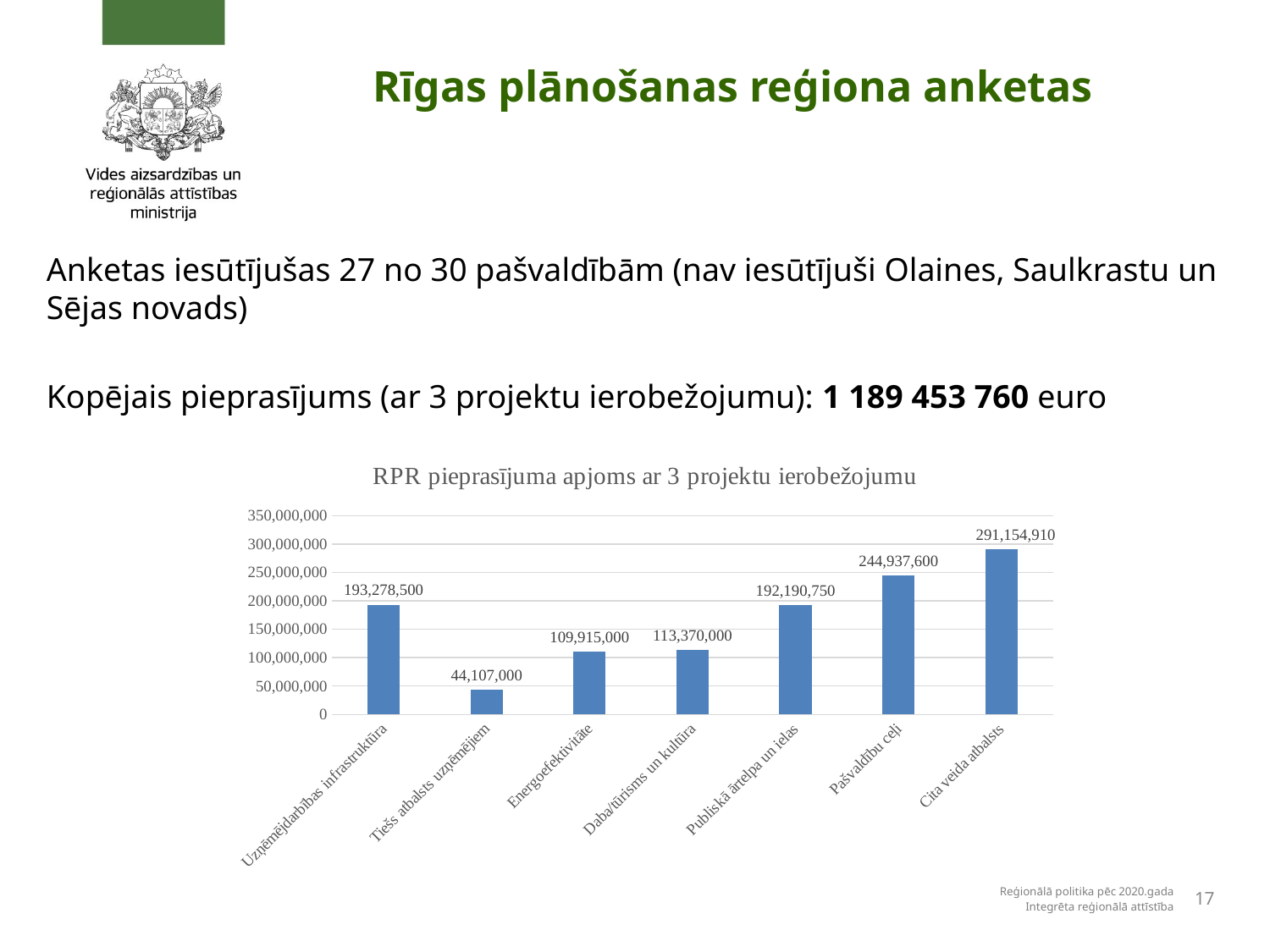
Which is larger, the value for Pašvaldību ceļi or the value for Publiskā ārtelpa un ielas? Pašvaldību ceļi What is the difference between the values for Cita veida atbalsts and Pašvaldību ceļi? 46,217,310 What is the value for Pašvaldību ceļi? 244,937,600 What is the difference between the values for Daba/tūrisms un kultūra and Energoefektivitāte? 3,455,000 How many categories are shown in the chart? 7 What is the value for Energoefektivitāte? 109,915,000 Which category has the highest value? Cita veida atbalsts What is the title of the chart? RPR pieprasījuma apjoms ar 3 projektu ierobežojumu What is the value for Tiešs atbalsts uzņēmējiem? 44,107,000 Which category has the lowest value? Tiešs atbalsts uzņēmējiem Is the value for Cita veida atbalsts greater or less than 250,000,000? greater What type of chart is shown on the slide? bar chart